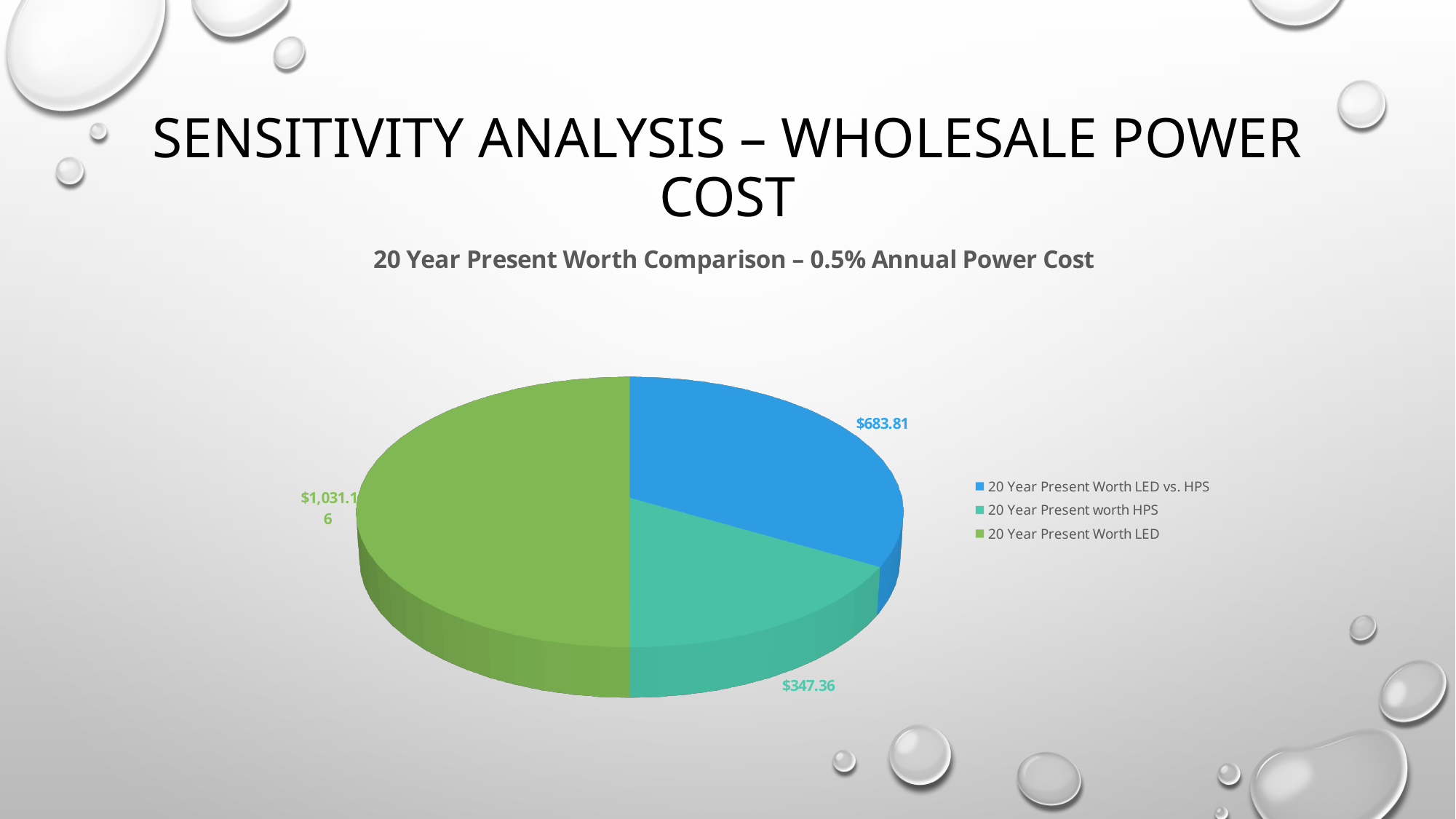
What is the value for 20 Year Present Worth LED? $1,031.16 Which category has the largest slice of the pie? 20 Year Present Worth LED What kind of chart is shown on the slide? Pie chart What is the value for 20 Year Present Worth LED vs. HPS? $683.81 What is the difference between the 20 Year Present Worth LED value and the 20 Year Present Worth LED vs. HPS value? $347.35 Which category has the smallest slice of the pie? 20 Year Present worth HPS What is the value for 20 Year Present worth HPS? $347.36 Which is larger, the value for 20 Year Present Worth LED vs. HPS or the value for 20 Year Present worth HPS? 20 Year Present Worth LED vs. HPS What is the difference between the 20 Year Present Worth LED vs. HPS value and the 20 Year Present worth HPS value? $336.45 How many slices does the pie chart have? 3 What is the title of the chart? 20 Year Present Worth Comparison – 0.5% Annual Power Cost What colour is the slice for 20 Year Present Worth LED? Green